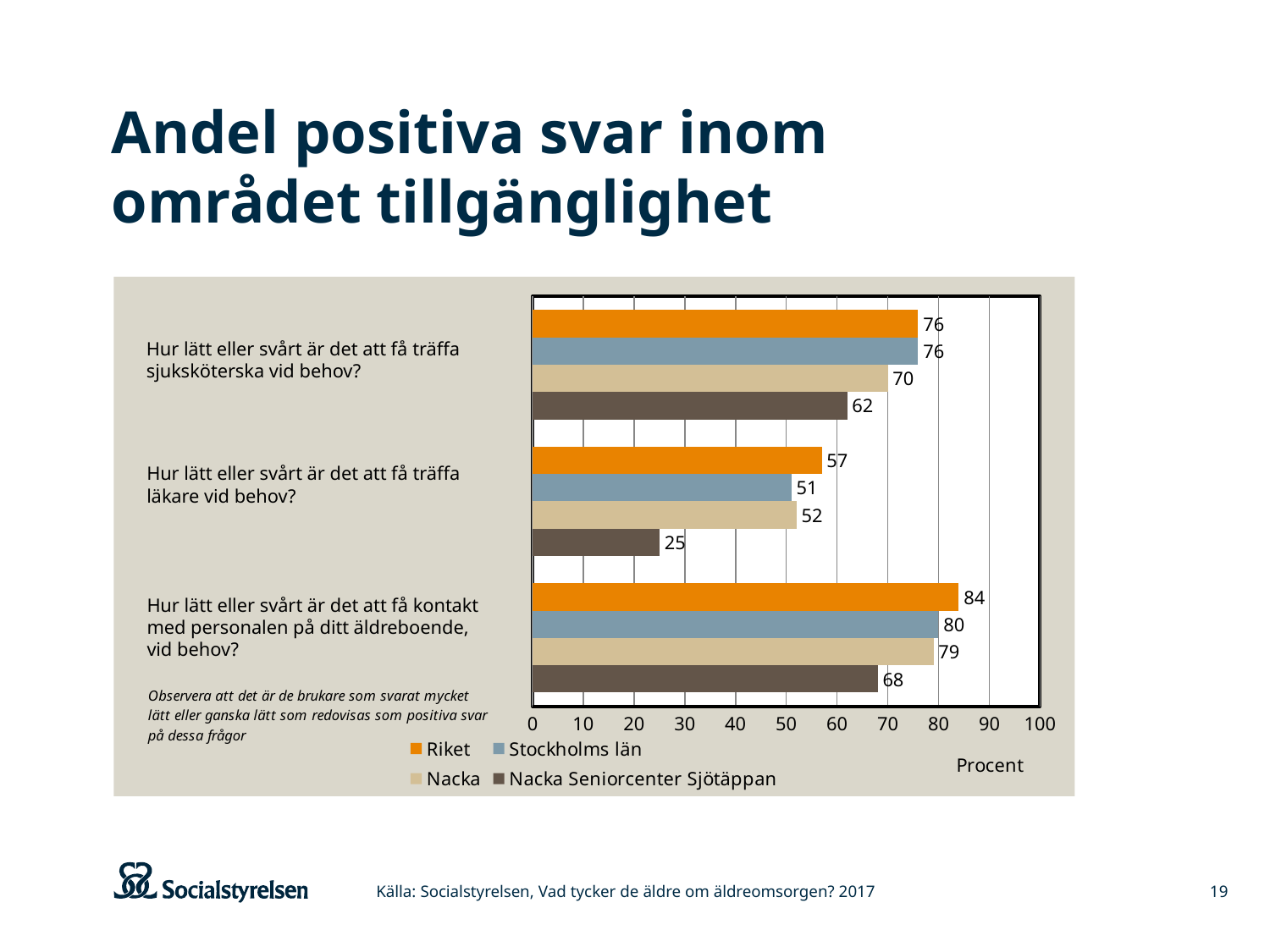
Is the value for Nacka Seniorcenter Sjötäppan on the question "Hur lätt eller svårt är det att få träffa läkare vid behov?" greater or less than 30? less Which series has the lowest value on the question "Hur lätt eller svårt är det att få träffa läkare vid behov?" Nacka Seniorcenter Sjötäppan What is the value for Stockholms län on the question "Hur lätt eller svårt är det att få kontakt med personalen på ditt äldreboende, vid behov?" 80 Which is larger on the question "Hur lätt eller svårt är det att få träffa sjuksköterska vid behov?": Nacka or Nacka Seniorcenter Sjötäppan? Nacka What is the difference between Riket and Nacka Seniorcenter Sjötäppan on the question "Hur lätt eller svårt är det att få träffa läkare vid behov?" 32 Which series has the highest value on the question "Hur lätt eller svårt är det att få kontakt med personalen på ditt äldreboende, vid behov?" Riket What is the value for Riket on the question "Hur lätt eller svårt är det att få träffa läkare vid behov?" 57 How many question categories are shown on the chart? 3 What kind of chart is shown on the slide? Bar chart How many series does the legend list? 4 What is the label of the horizontal axis? Procent What is the value for Nacka Seniorcenter Sjötäppan on the question "Hur lätt eller svårt är det att få träffa sjuksköterska vid behov?" 62